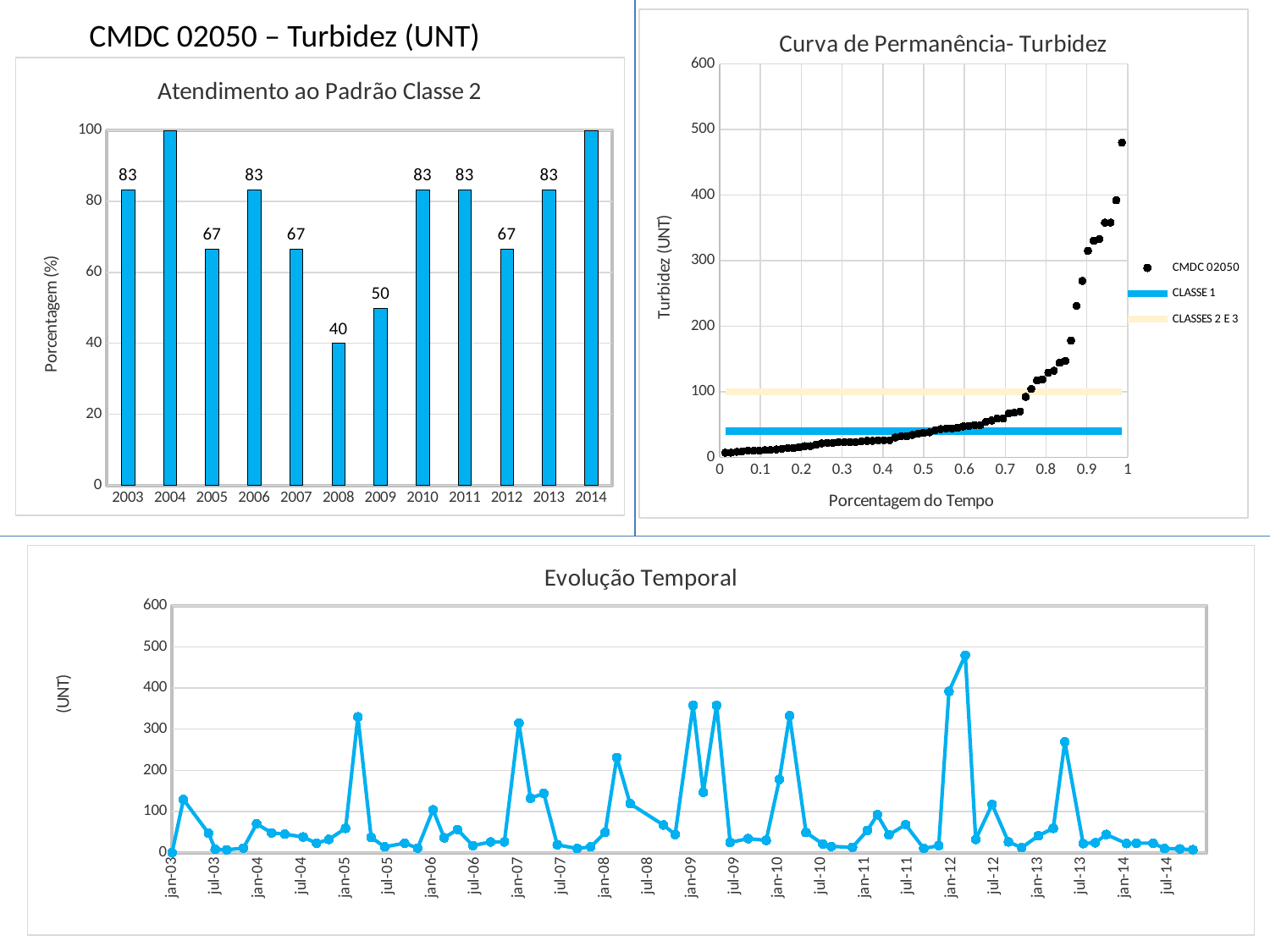
What kind of chart is 'Atendimento ao Padrão Classe 2'? bar chart In the 'Atendimento ao Padrão Classe 2' chart, is the value for 2004 greater or less than 80? greater In the 'Atendimento ao Padrão Classe 2' chart, what is the value for 2008? 40 In the 'Atendimento ao Padrão Classe 2' chart, which year has the lowest value? 2008 In the 'Atendimento ao Padrão Classe 2' chart, which is larger, the value for 2009 or the value for 2012? 2012 In the 'Atendimento ao Padrão Classe 2' chart, what is the value for 2009? 50 In the 'Atendimento ao Padrão Classe 2' chart, what is the difference between the values for 2003 and 2008? 43 What is the x-axis title of the 'Curva de Permanência- Turbidez' chart? Porcentagem do Tempo How many series does the legend of the 'Curva de Permanência- Turbidez' chart list? 3 In the 'Evolução Temporal' chart, is the highest plotted value greater or less than 400? greater In the 'Atendimento ao Padrão Classe 2' chart, how many years are shown on the x axis? 12 What kind of chart is 'Evolução Temporal'? line chart